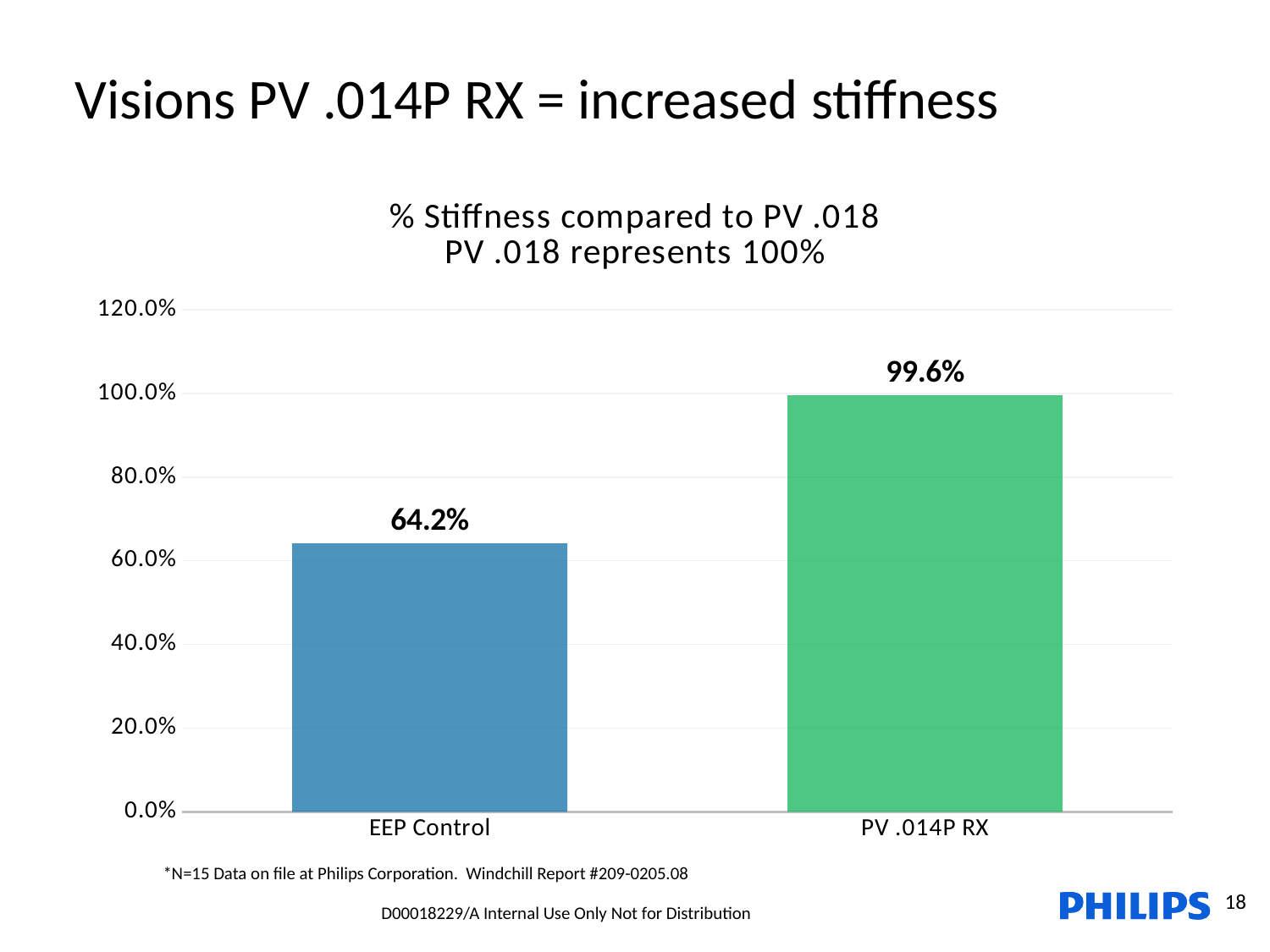
What is the title of the chart? % Stiffness compared to PV .018 PV .018 represents 100% Which is larger, the value for EEP Control or the value for PV .014P RX? PV .014P RX What is the difference between the values for PV .014P RX and EEP Control? 35.4% What is the value for PV .014P RX? 99.6% What kind of chart is shown on the slide? Bar chart Which category has the lowest value? EEP Control Is the value for PV .014P RX greater or less than 80.0%? greater What colour is the bar for PV .014P RX? Green What is the value for EEP Control? 64.2% Which category has the highest value? PV .014P RX How many categories are shown on the chart? 2 Is the value for EEP Control greater or less than 80.0%? less